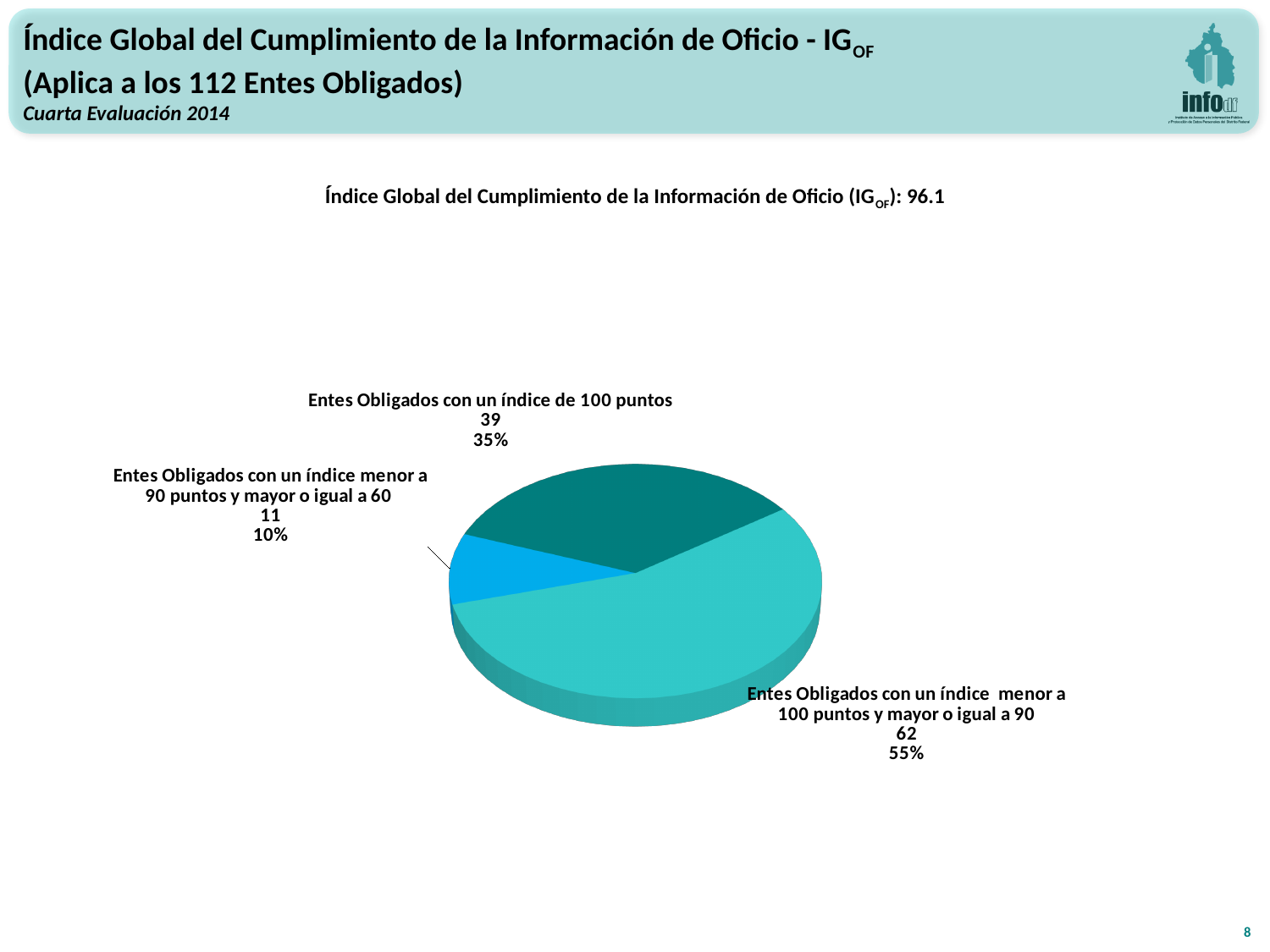
Which is larger: the number of Entes Obligados with an index of 100 points or those with an index below 90 and at least 60? Entes Obligados con un índice de 100 puntos Which category has the largest slice of the pie? Entes Obligados con un índice menor a 100 puntos y mayor o igual a 90 What share of the pie corresponds to Entes Obligados with an index of 100 points? 35% What share of the pie corresponds to Entes Obligados with an index less than 90 points and greater than or equal to 60? 10% Which category has the smallest slice of the pie? Entes Obligados con un índice menor a 90 puntos y mayor o igual a 60 How many Entes Obligados have an index less than 90 points and greater than or equal to 60? 11 How many Entes Obligados have an index of 100 points? 39 How many categories does the pie chart show? 3 What kind of chart is shown on the slide? pie chart How many Entes Obligados have an index less than 100 points and greater than or equal to 90? 62 What value of the Índice Global del Cumplimiento de la Información de Oficio (IGOF) is stated above the chart? 96.1 What is the difference between the number of Entes Obligados with an index below 100 and at least 90 and those with an index of 100 points? 23